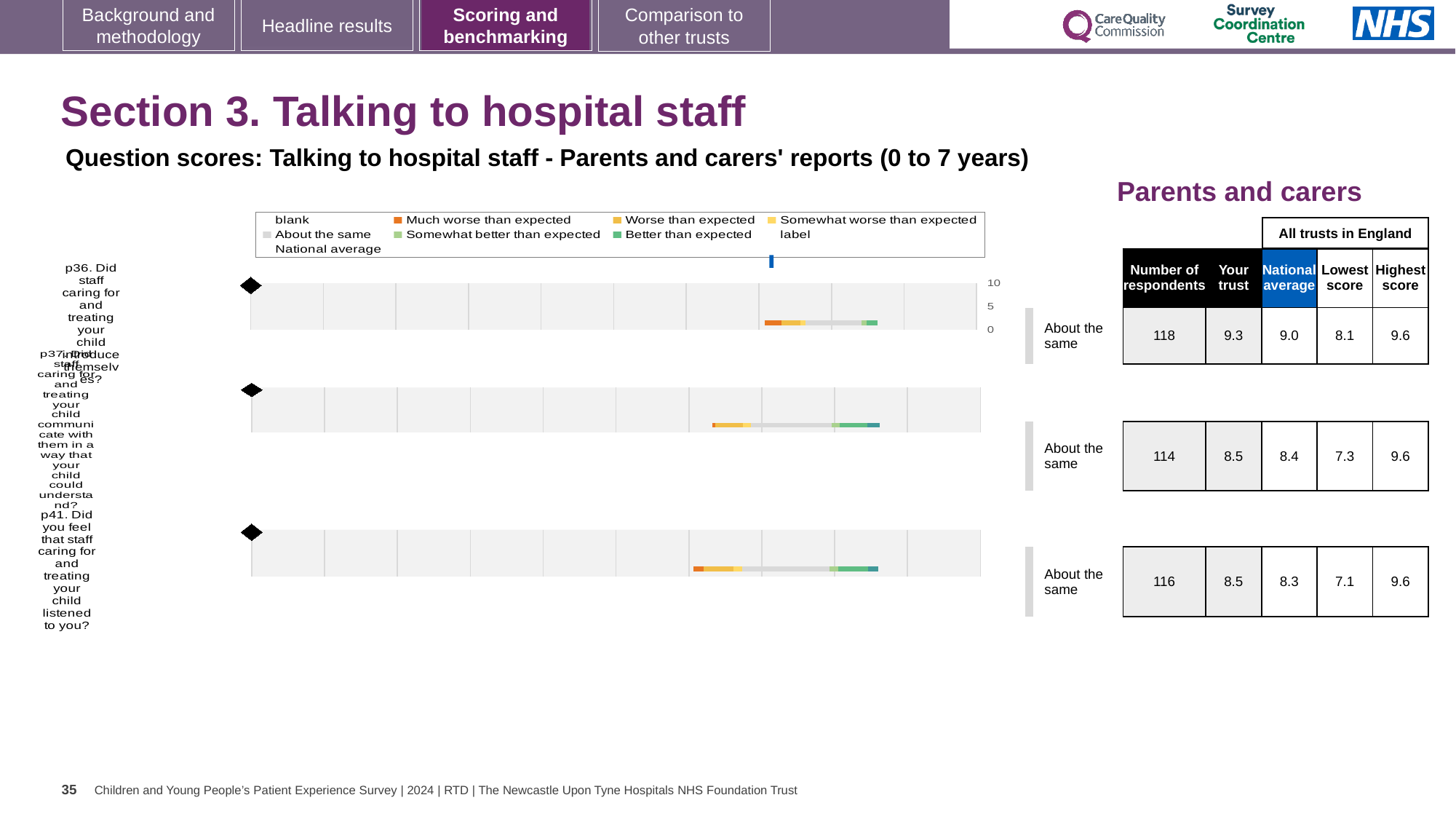
What kind of chart is used for the three question rows (p36, p37, p41) on this slide? bar chart In the table beside the p37 chart, what is the 'National average' score? 8.4 What is the heading printed above the table to the right of the charts? Parents and carers What is the difference between the 'Your trust' score and the 'National average' for the p36 row? 0.3 How many entries does the legend above the charts list? 9 How many question charts (rows) are plotted on this slide? 3 Which of the three question rows has the highest 'Your trust' score in the table? p36 In the table beside the p36 chart, how many respondents are listed? 118 What benchmark label is shown next to each of the three charts? About the same In the table beside the p41 chart, what is the 'Lowest score'? 7.1 In the legend, which colour represents 'Much worse than expected'? orange In the table beside the p36 chart, what is the 'Your trust' score? 9.3